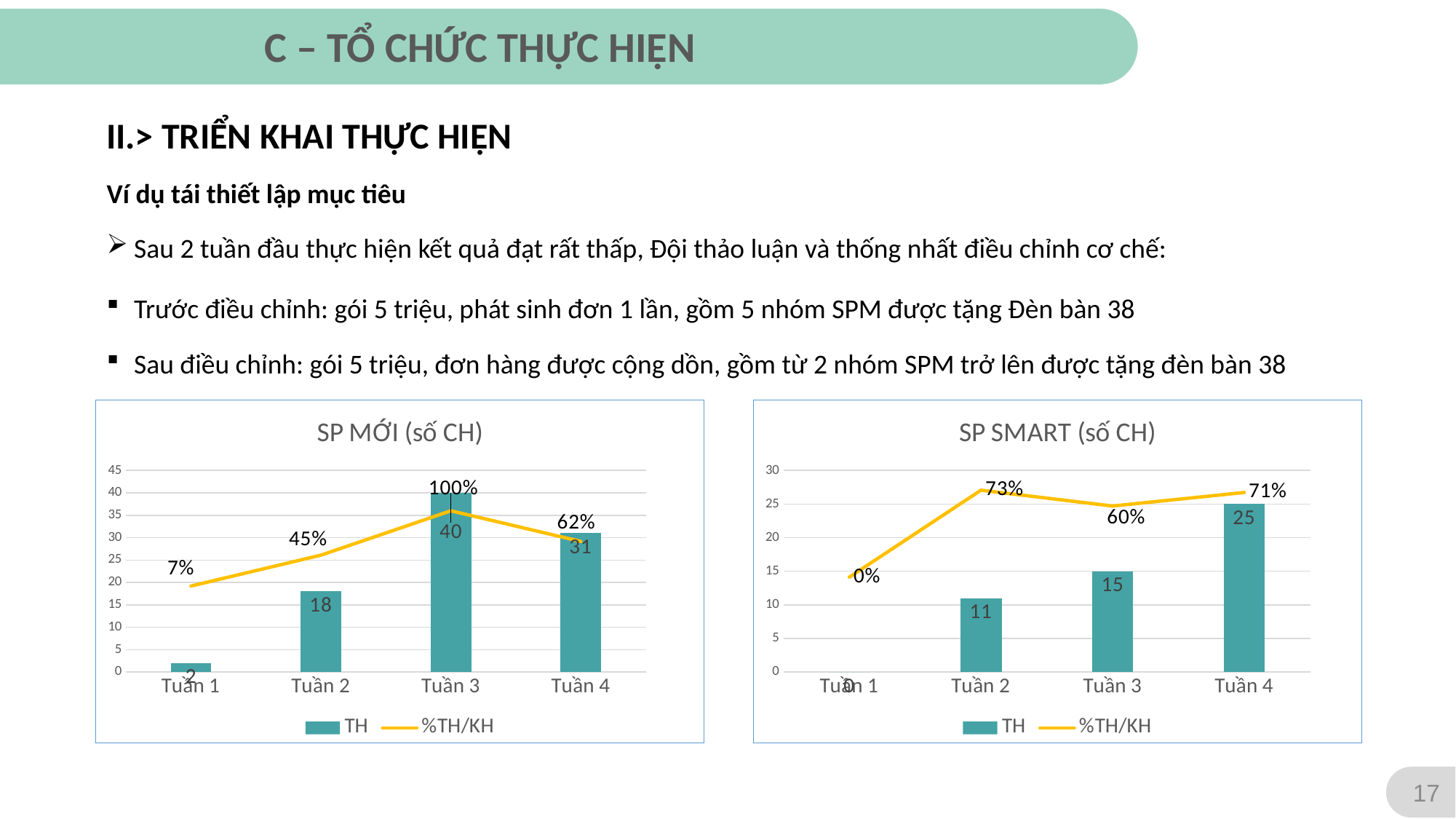
In the SP MỚI (số CH) chart, how many series does the legend list? 2 In the SP SMART (số CH) chart, is the TH value for Tuần 2 larger or smaller than the TH value for Tuần 3? smaller In the SP MỚI (số CH) chart, what is the %TH/KH value for Tuần 2? 45% In the SP SMART (số CH) chart, do the TH bar values rise or fall from Tuần 1 to Tuần 4? rise In the SP MỚI (số CH) chart, which week has the lowest TH value? Tuần 1 In the SP SMART (số CH) chart, which week has the highest %TH/KH value? Tuần 2 In the SP SMART (số CH) chart, what is the %TH/KH value for Tuần 3? 60% In the SP MỚI (số CH) chart, what is the TH value for Tuần 3? 40 What type of chart is used for the TH series in the SP MỚI (số CH) chart? bar chart In the SP SMART (số CH) chart, what is the TH value for Tuần 4? 25 In the SP MỚI (số CH) chart, what is the difference between the TH values for Tuần 3 and Tuần 4? 9 In the SP SMART (số CH) chart, how many weeks are shown on the x axis? 4